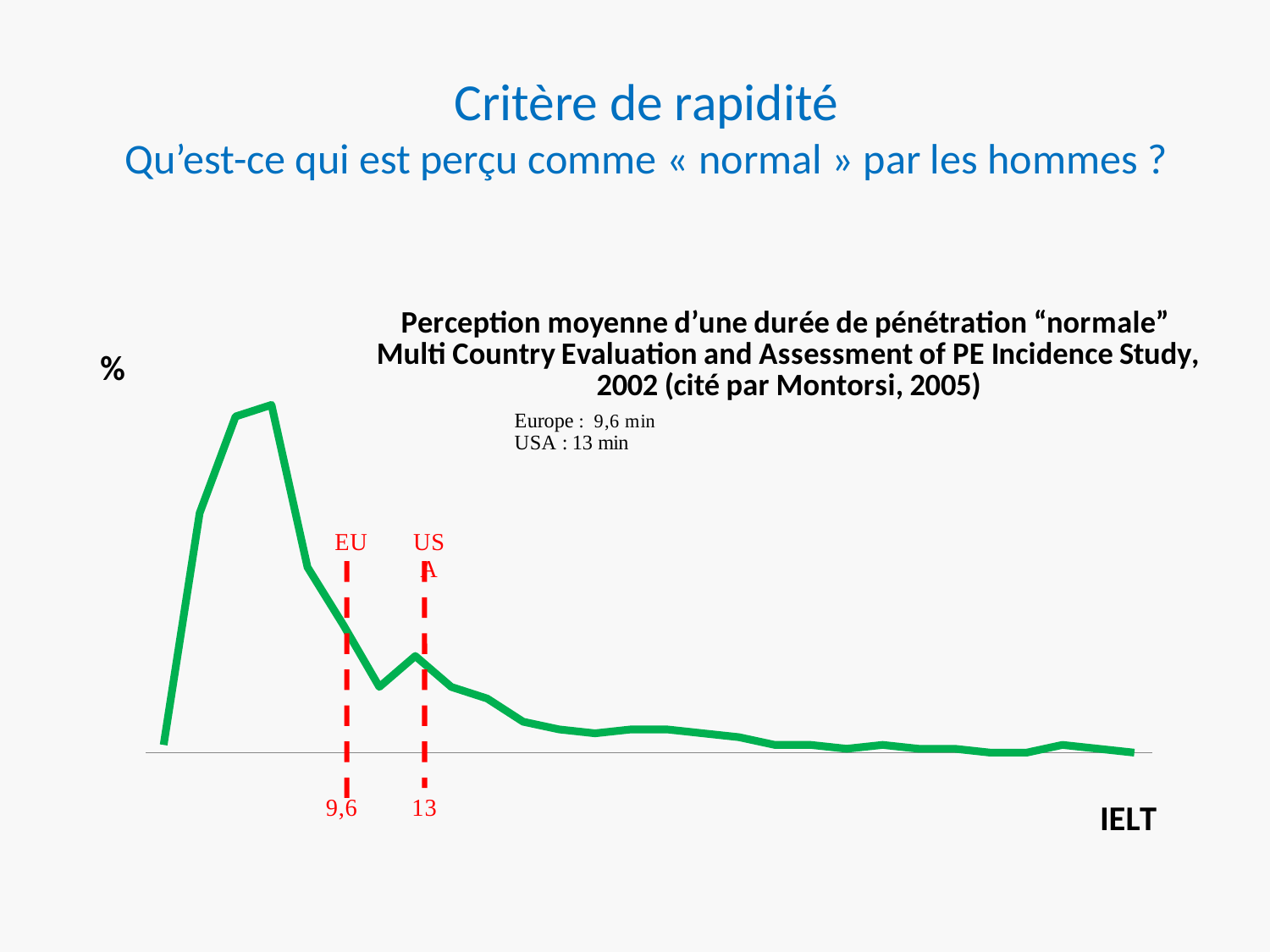
After reaching its peak, does the green line mainly rise or fall as IELT increases along the x axis? fall According to the text on the chart, what is the average perceived 'normal' duration for Europe? 9,6 min What label is shown on the vertical axis of the chart? % What IELT value is marked by the dashed line labelled USA? 13 According to the text on the chart, what is the average perceived 'normal' duration for the USA? 13 min What label is shown on the horizontal axis of the chart? IELT What kind of chart is shown on the slide? line chart Which marked IELT value is larger, EU or USA? USA What is the difference between the USA marker (13) and the EU marker (9,6) on the x axis? 3,4 What IELT value is marked by the dashed line labelled EU? 9,6 How many data series (lines) are plotted on the chart? 1